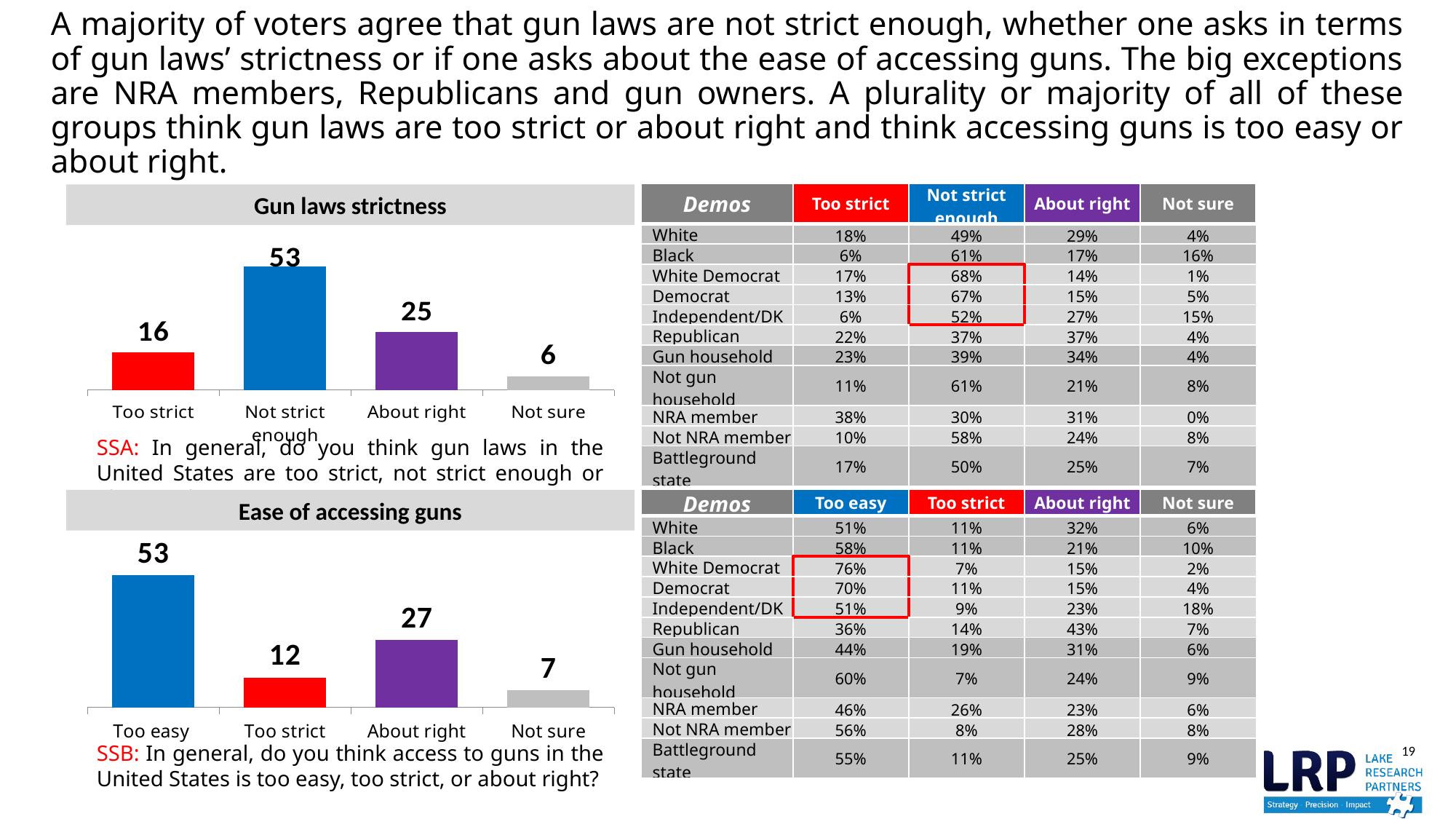
In the 'Gun laws strictness' chart, how many categories are shown? 4 In the 'Ease of accessing guns' chart, what is the value for 'About right'? 27 In the 'Ease of accessing guns' chart, what is the difference between 'Too easy' and 'Too strict'? 41 In the 'Ease of accessing guns' chart, which is larger, 'Too strict' or 'About right'? About right In the 'Gun laws strictness' chart, what is the value for 'Not strict enough'? 53 In the 'Ease of accessing guns' chart, which category has the highest value? Too easy In the 'Gun laws strictness' chart, what is the difference between 'Not strict enough' and 'About right'? 28 In the 'Gun laws strictness' chart, what colour is the 'About right' bar? Purple In the 'Gun laws strictness' chart, what is the value for 'Too strict'? 16 What kind of chart is the 'Ease of accessing guns' chart? Bar chart In the 'Gun laws strictness' chart, which category has the lowest value? Not sure In the 'Ease of accessing guns' chart, what is the value for 'Too easy'? 53